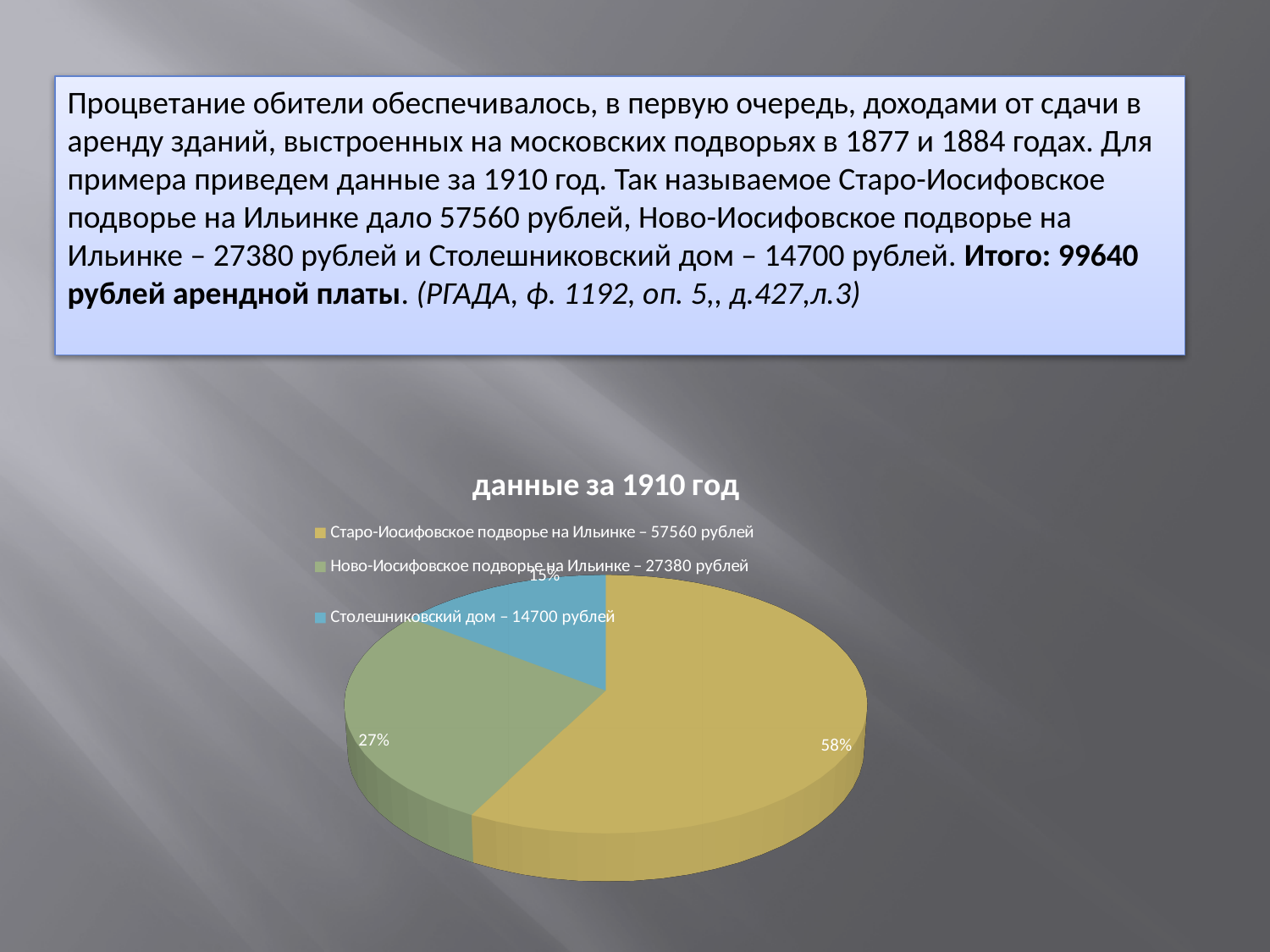
What kind of chart is shown on the slide? pie chart What share of the pie does the slice for Столешниковский дом represent? 15% What share of the pie does the slice for Старо-Иосифовское подворье на Ильинке represent? 58% How many entries does the chart legend list? 3 What colour is the slice for Столешниковский дом? blue What is the title of the chart? данные за 1910 год Which category has the smallest slice of the pie? Столешниковский дом What share of the pie does the slice for Ново-Иосифовское подворье на Ильинке represent? 27% What is the difference in percentage points between the slice for Старо-Иосифовское подворье на Ильинке and the slice for Ново-Иосифовское подворье на Ильинке? 31 percentage points How many slices does the pie chart have? 3 Which slice is larger: Ново-Иосифовское подворье на Ильинке or Столешниковский дом? Ново-Иосифовское подворье на Ильинке Which category has the largest slice of the pie? Старо-Иосифовское подворье на Ильинке